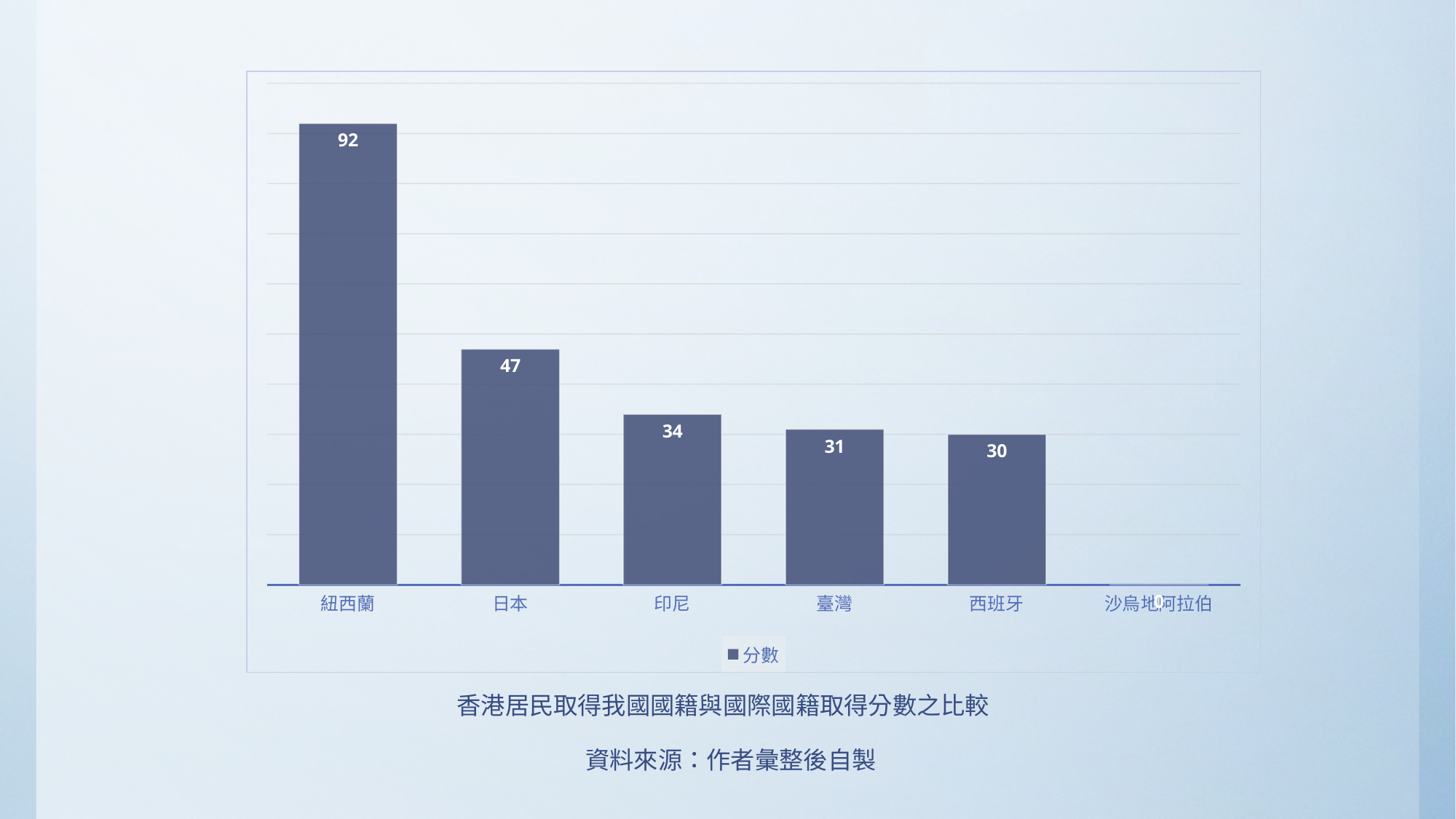
What is the difference between the values for 紐西蘭 and 日本? 45 What is the value for 印尼? 34 What is the value for 紐西蘭? 92 Which category has the highest value? 紐西蘭 What is the value for 日本? 47 How many categories are shown on the x axis? 6 Which is larger, the value for 日本 or the value for 印尼? 日本 Which category has the lowest value? 沙烏地阿拉伯 What is the value for 臺灣? 31 What is the value for 西班牙? 30 What kind of chart is shown on the slide? bar chart What series name does the legend show? 分數